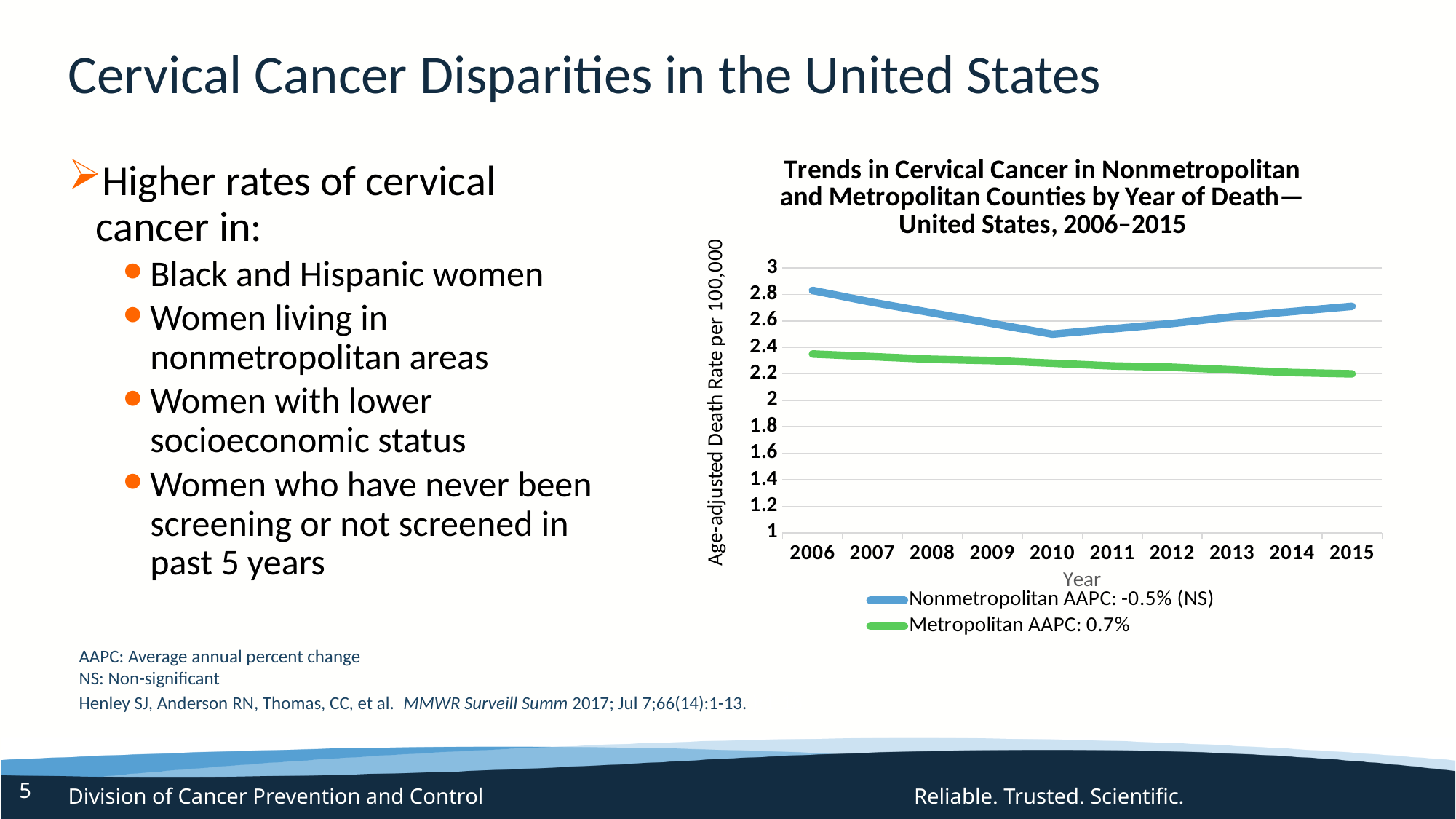
Does the Metropolitan line rise or fall from 2006 to 2015? fall How many years are shown along the x axis of the chart? 10 What is the label on the y axis of the chart? Age-adjusted Death Rate per 100,000 What kind of chart is shown on the slide? line chart How many series does the chart's legend list? 2 Is the Metropolitan value for 2015 greater or less than 2.4? less Is the Nonmetropolitan value for 2006 greater or less than 2.6? greater Is the Metropolitan value for 2006 greater or less than 2.2? greater Which series has the higher value in 2010, Nonmetropolitan or Metropolitan? Nonmetropolitan What AAPC does the legend give for the Metropolitan series? 0.7% Which series is higher across all years shown, Nonmetropolitan or Metropolitan? Nonmetropolitan